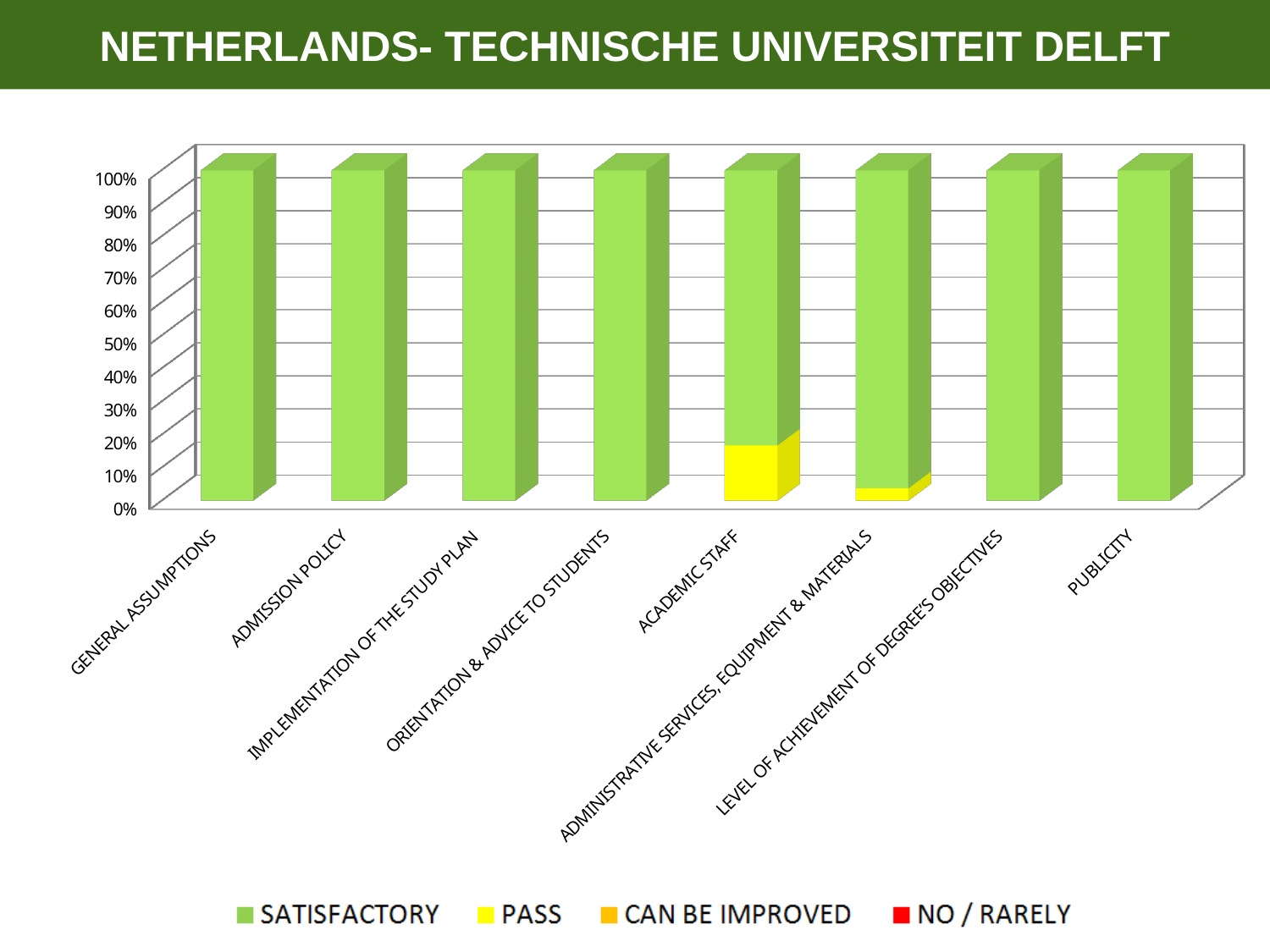
How many series does the chart's legend list? 4 How many categories show a visible PASS segment? 2 Is the SATISFACTORY value for ACADEMIC STAFF greater or less than 50%? greater What is the total height of the stacked bar for PUBLICITY? 100% What kind of chart is shown on the slide? Stacked bar chart How many categories are shown along the x axis of the chart? 8 Which category has the largest PASS segment? ACADEMIC STAFF What is the title of the slide containing the chart? NETHERLANDS- TECHNISCHE UNIVERSITEIT DELFT Is the PASS value for ACADEMIC STAFF greater or less than 30%? less Is the PASS value for ADMINISTRATIVE SERVICES, EQUIPMENT & MATERIALS greater or less than 10%? less Which legend entry is shown in yellow? PASS Is the PASS segment for ACADEMIC STAFF larger or smaller than the PASS segment for ADMINISTRATIVE SERVICES, EQUIPMENT & MATERIALS? Larger